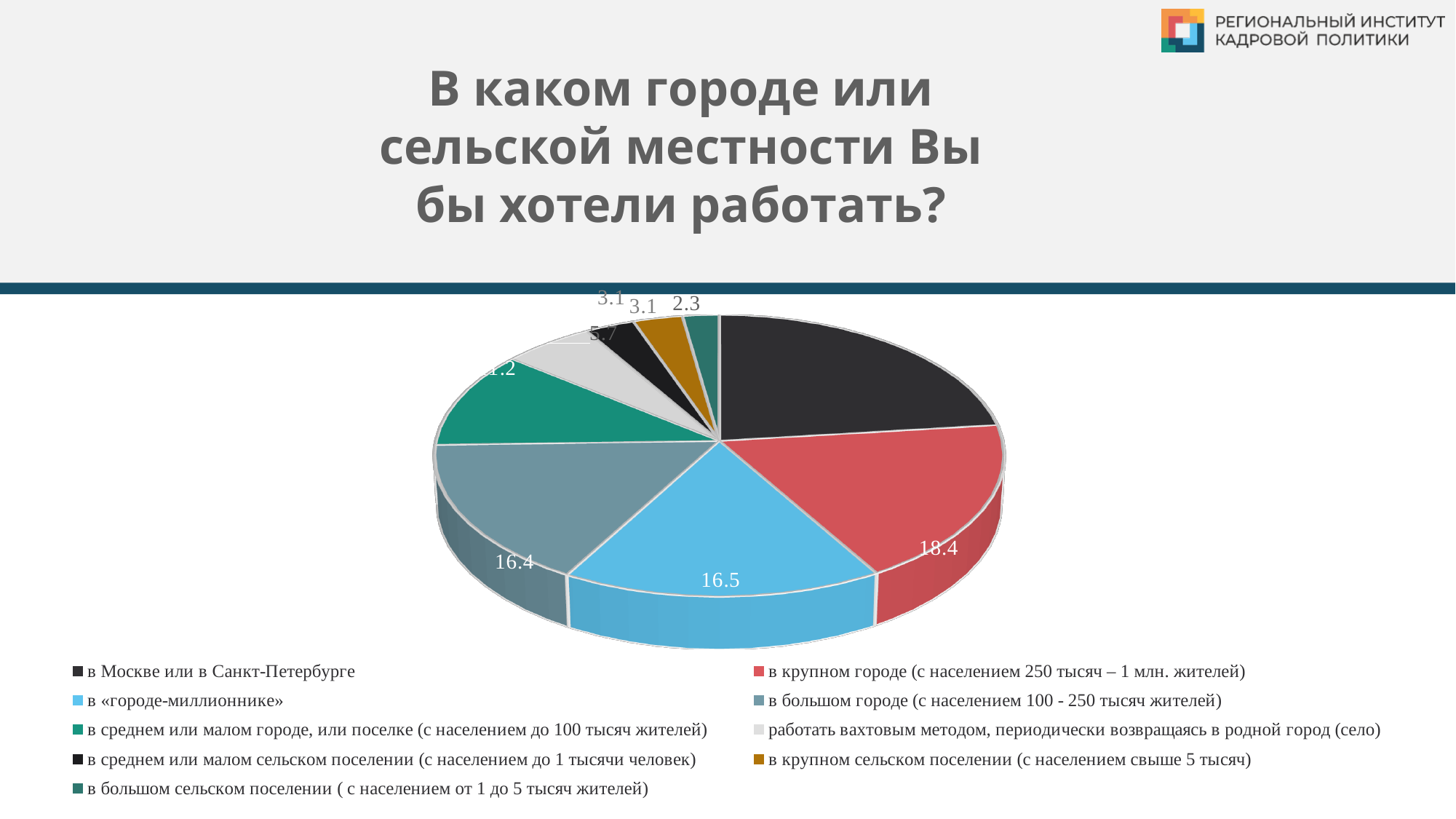
What is the difference between the values for «в крупном городе (с населением 250 тысяч – 1 млн. жителей)» and «в «городе-миллионнике»»? 1.9 Which category has the smallest slice of the pie? в большом сельском поселении ( с населением от 1 до 5 тысяч жителей) Which is larger: the value for «в крупном городе (с населением 250 тысяч – 1 млн. жителей)» or for «в «городе-миллионнике»»? в крупном городе (с населением 250 тысяч – 1 млн. жителей) Which category has the largest slice of the pie? в Москве или в Санкт-Петербурге What is the value for «в большом городе (с населением 100 - 250 тысяч жителей)»? 16.4 What is the value for «в «городе-миллионнике»»? 16.5 What kind of chart is shown on the slide? pie chart What is the value for «в большом сельском поселении ( с населением от 1 до 5 тысяч жителей)»? 2.3 What is the value for «в крупном городе (с населением 250 тысяч – 1 млн. жителей)»? 18.4 What is the value for «в крупном сельском поселении (с населением свыше 5 тысяч)»? 3.1 How many categories does the pie chart have? 9 What colour is the slice for «в Москве или в Санкт-Петербурге»? dark grey